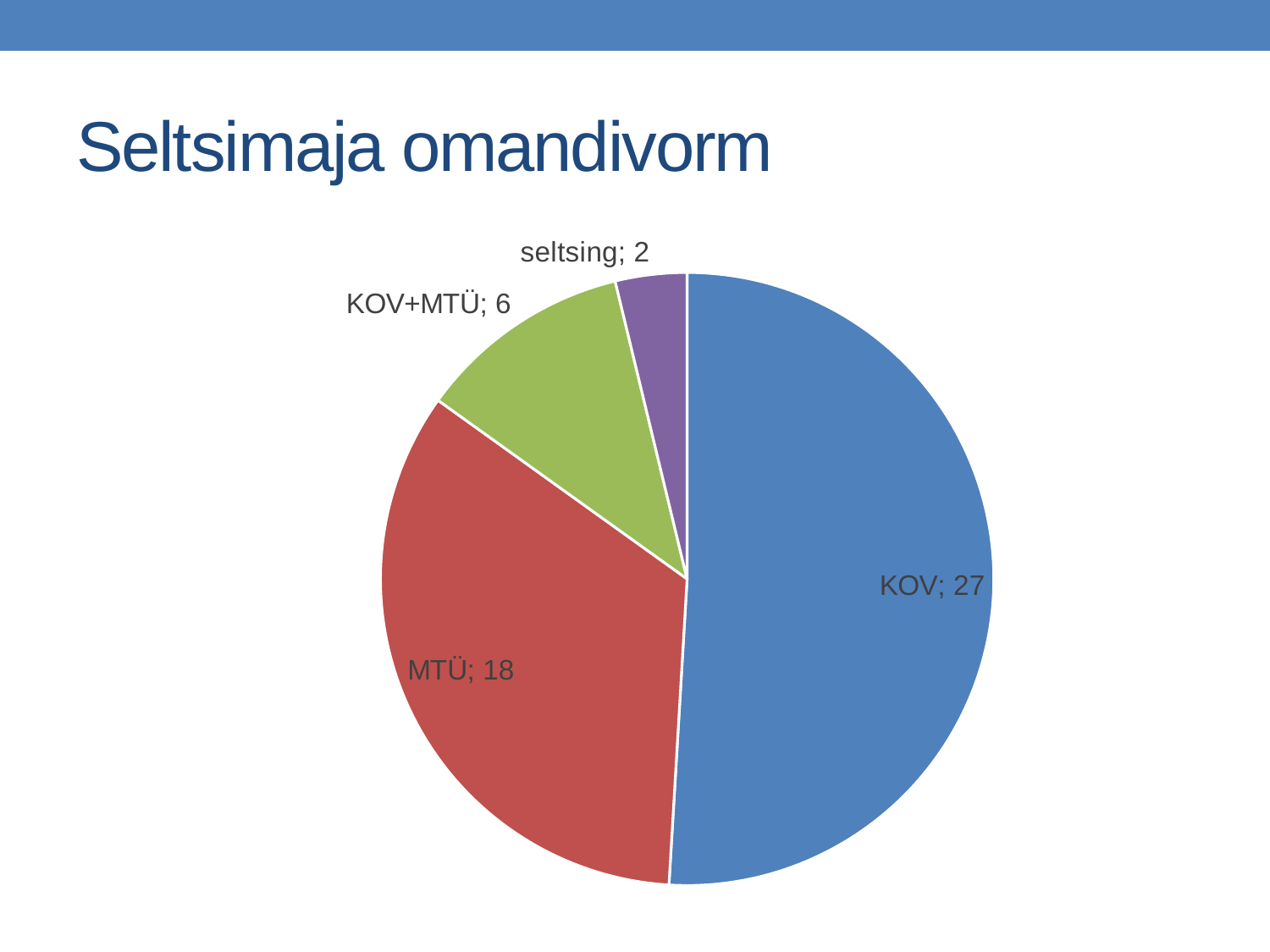
What is the value for KOV? 27 Which category has the largest slice? KOV Which is larger, the value for KOV+MTÜ or the value for seltsing? KOV+MTÜ What is the value for MTÜ? 18 What is the difference between the values for KOV and MTÜ? 9 How many categories are shown in the pie chart? 4 What is the value for seltsing? 2 What is the title of the slide containing the chart? Seltsimaja omandivorm What is the total of all slices in the pie chart? 53 What type of chart is shown on the slide? pie chart What is the value for KOV+MTÜ? 6 Which category has the smallest slice? seltsing